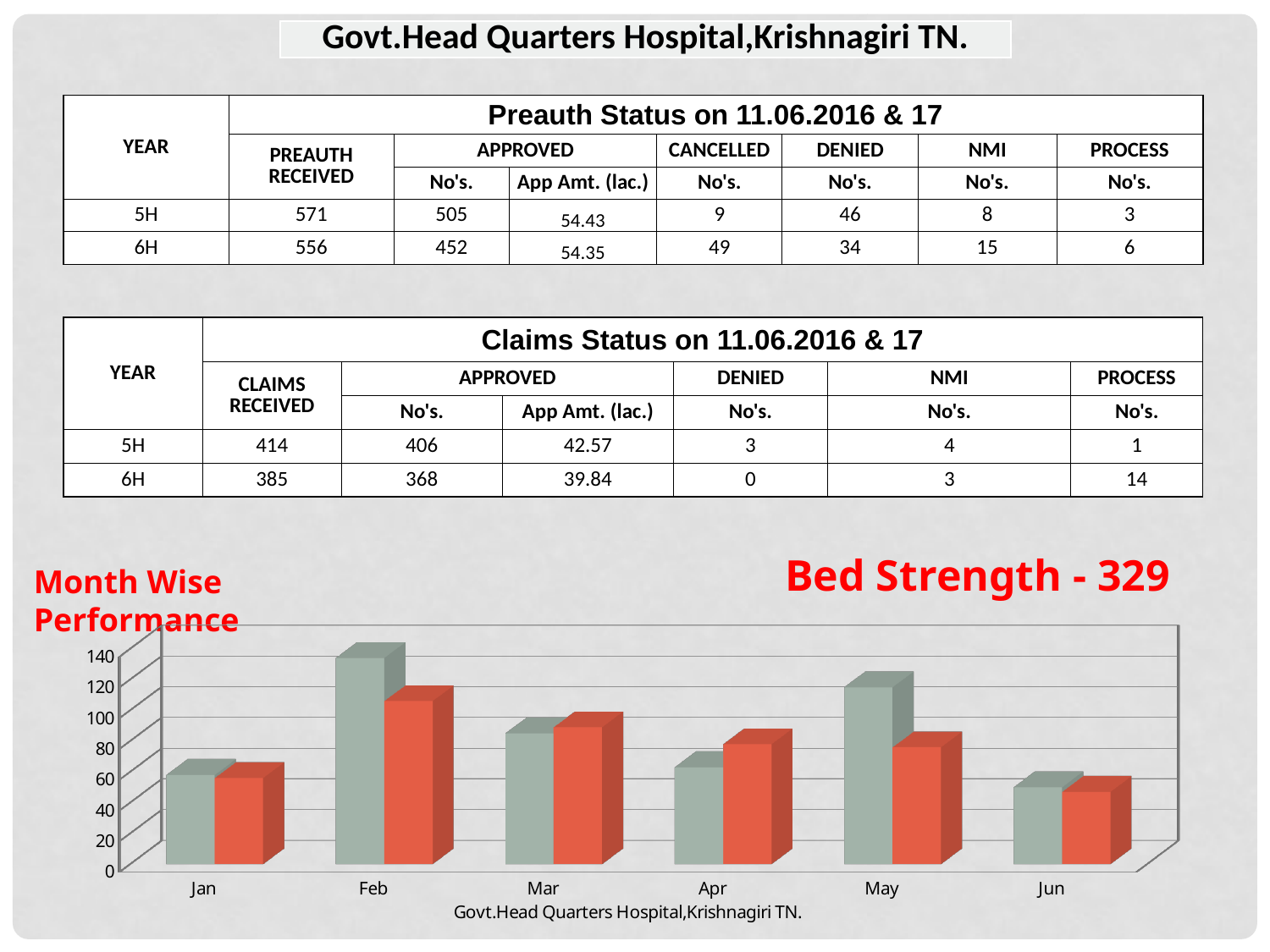
How many months are shown on the x axis of the Month Wise Performance chart? 6 In the Month Wise Performance chart, which month has the tallest grey bar? Feb In the Month Wise Performance chart, is the grey bar for Feb greater or less than 120? greater In the Month Wise Performance chart, is the grey bar for May greater or less than 100? greater In the Month Wise Performance chart, which is larger for Apr, the grey bar or the red bar? the red bar In the Month Wise Performance chart, is the red bar for Apr greater or less than 100? less What kind of chart is shown at the bottom of the slide? bar chart What text appears below the x axis of the Month Wise Performance chart? Govt.Head Quarters Hospital,Krishnagiri TN. In the Month Wise Performance chart, which month has the tallest red bar? Feb In the Month Wise Performance chart, which is larger for May, the grey bar or the red bar? the grey bar In the Month Wise Performance chart, which month has the shortest grey bar? Jun